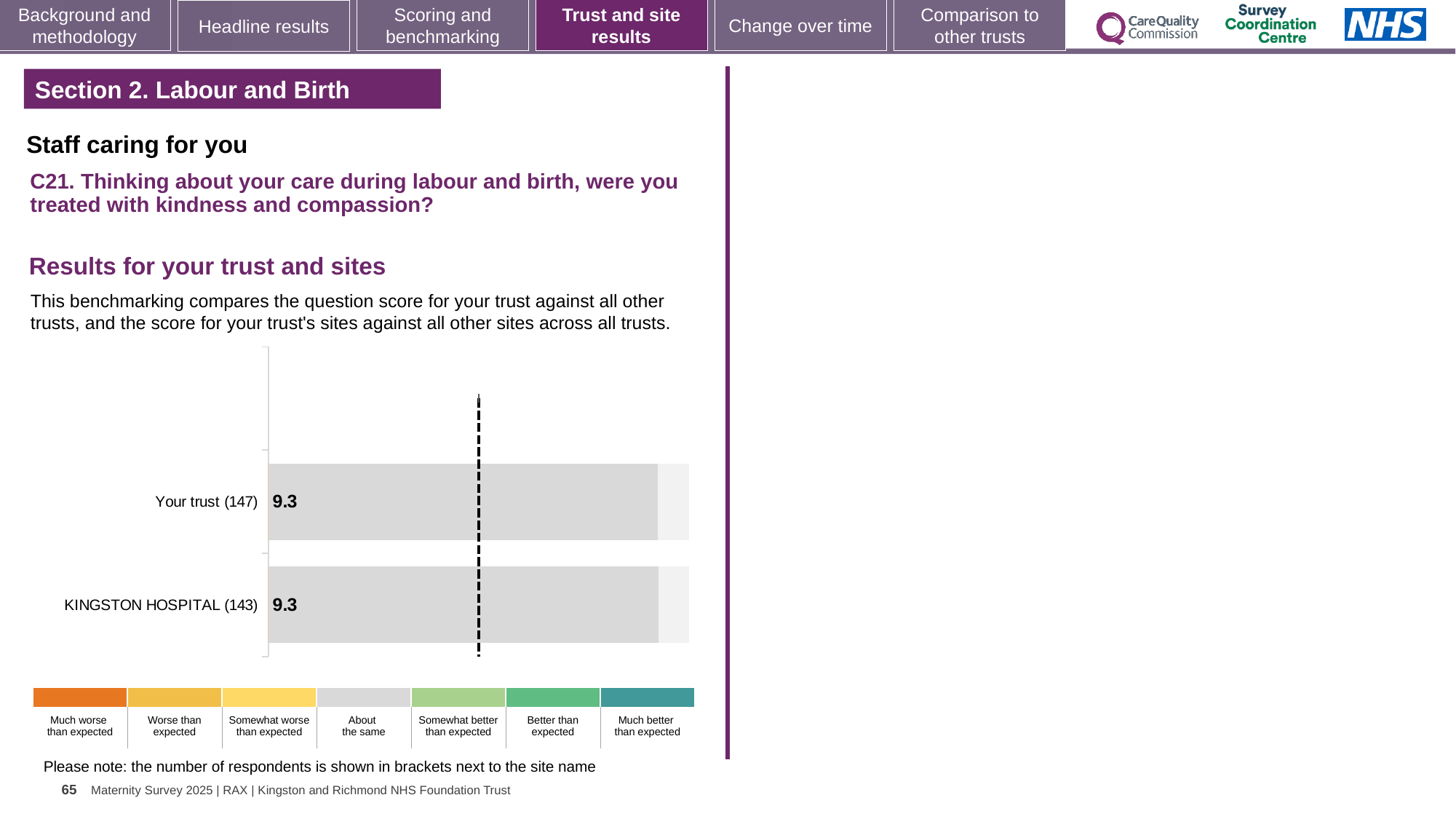
What is the difference between the score for Your trust (147) and the score for KINGSTON HOSPITAL (143)? 0 What kind of chart is shown on the slide? Bar chart What is the score for Your trust (147)? 9.3 What is the score for KINGSTON HOSPITAL (143)? 9.3 How many categories does the colour key below the chart list? 7 How many respondents are shown in brackets for KINGSTON HOSPITAL? 143 Which category in the colour key does the grey colour of the bars correspond to? About the same How many respondents are shown in brackets for Your trust? 147 Which survey question does the chart relate to? C21. Thinking about your care during labour and birth, were you treated with kindness and compassion? Is the score for Your trust (147) larger than, smaller than, or equal to the score for KINGSTON HOSPITAL (143)? Equal How many bars are plotted in the chart? 2